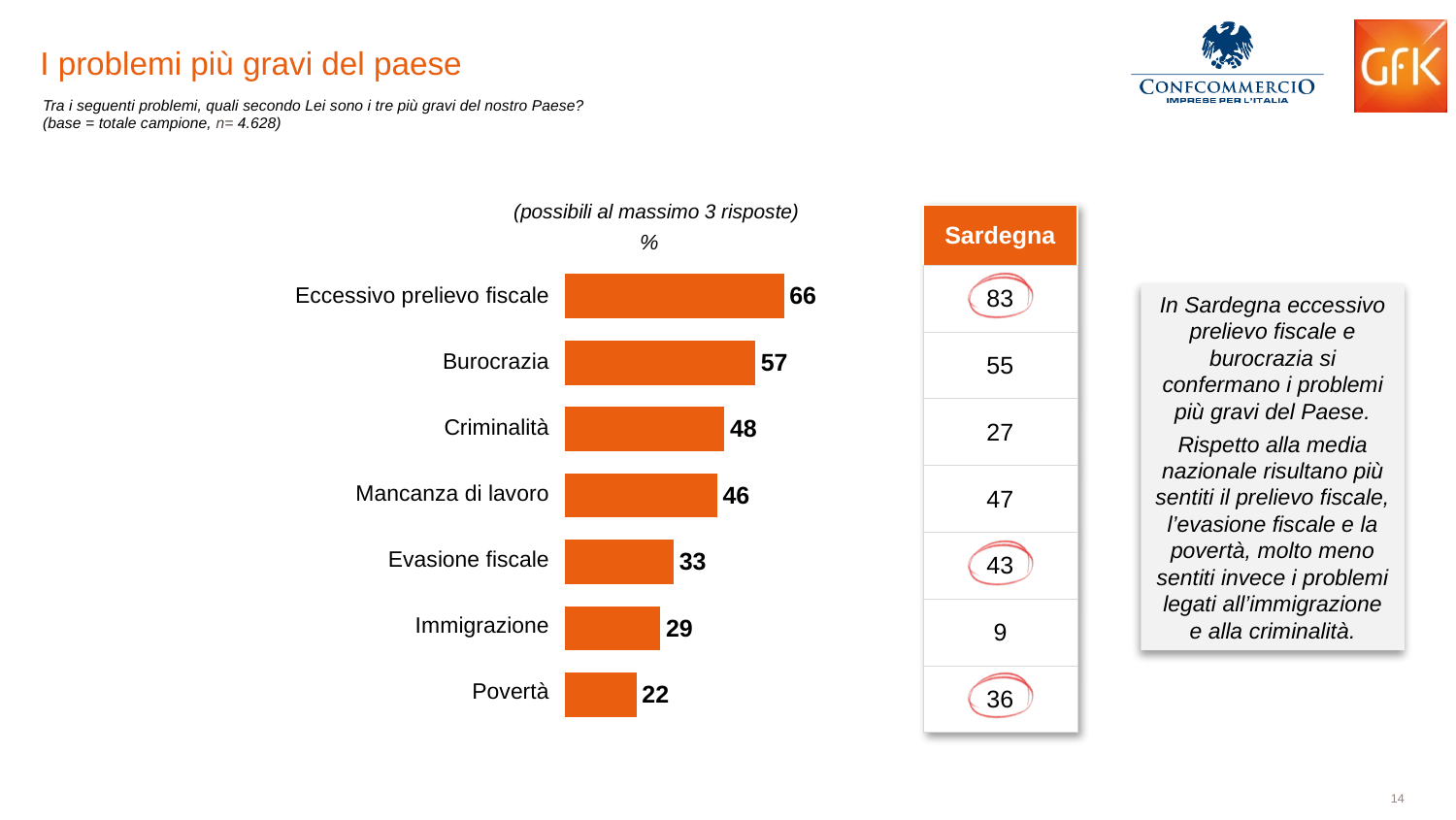
How many categories are shown in the bar chart? 7 What is the difference between the values for Eccessivo prelievo fiscale and Burocrazia? 9 What is the title of the slide containing the bar chart? I problemi più gravi del paese What is the difference between the values for Evasione fiscale and Povertà? 11 What is the value for Burocrazia in the bar chart? 57 What is the value for Immigrazione in the bar chart? 29 What is the value for Eccessivo prelievo fiscale in the bar chart? 66 Which category has the highest value in the bar chart? Eccessivo prelievo fiscale Which category has the lowest value in the bar chart? Povertà Which is larger, the value for Criminalità or the value for Mancanza di lavoro? Criminalità What kind of chart is shown on the slide? Bar chart What is the value for Mancanza di lavoro in the bar chart? 46